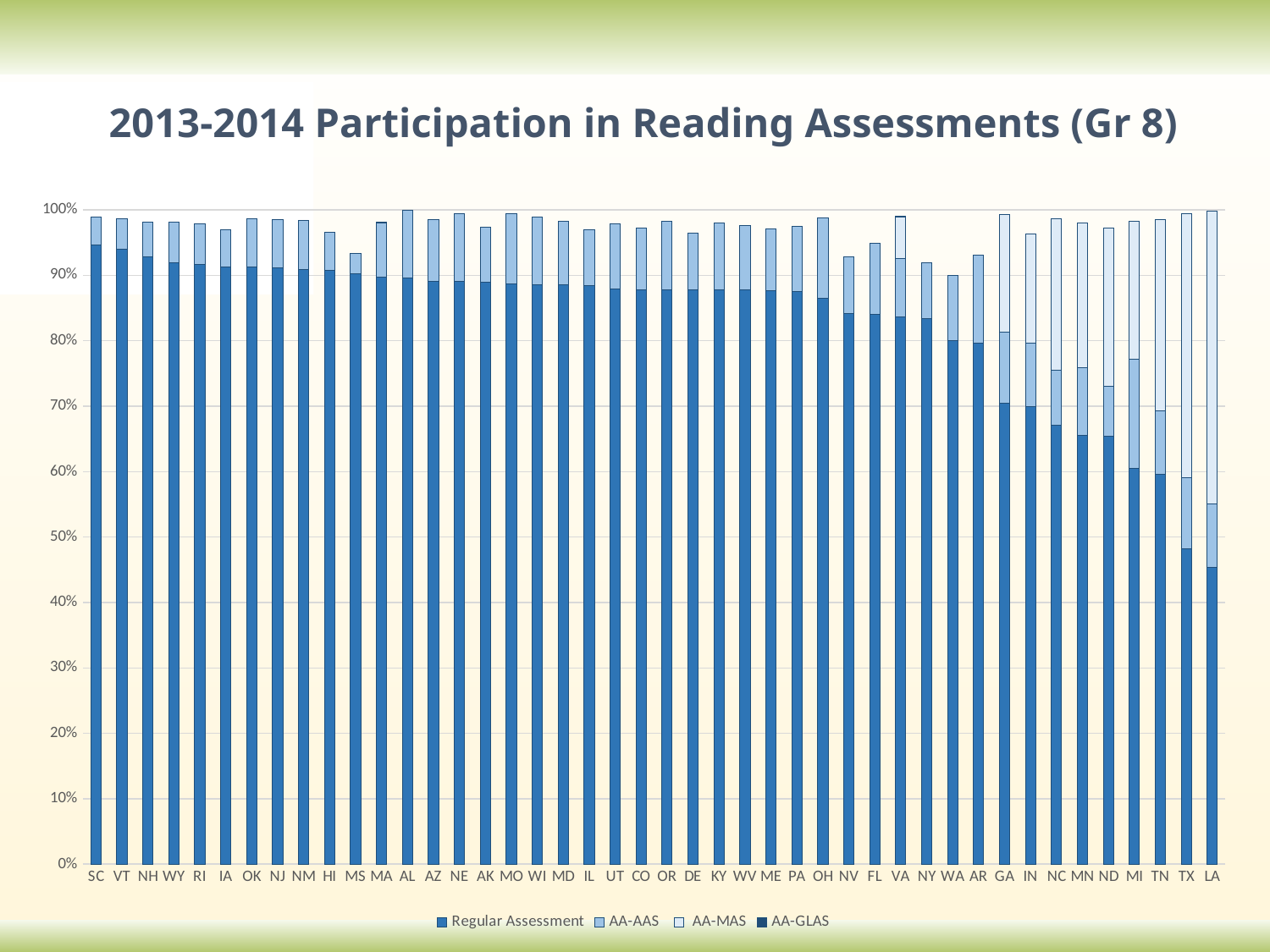
Is the Regular Assessment value for TN greater or less than 50%? greater How many states are shown along the x axis? 44 Is the Regular Assessment value for SC greater or less than 90%? greater Which state has the lowest Regular Assessment value? LA How many series does the legend list? 4 Do the Regular Assessment values generally rise or fall from left to right along the x axis? fall Which has the larger Regular Assessment value, SC or TX? SC Is the Regular Assessment value for GA greater or less than 80%? less What kind of chart is shown on the slide? Stacked bar chart Which series are listed in the legend? Regular Assessment, AA-AAS, AA-MAS, AA-GLAS What is the title of the chart? 2013-2014 Participation in Reading Assessments (Gr 8)